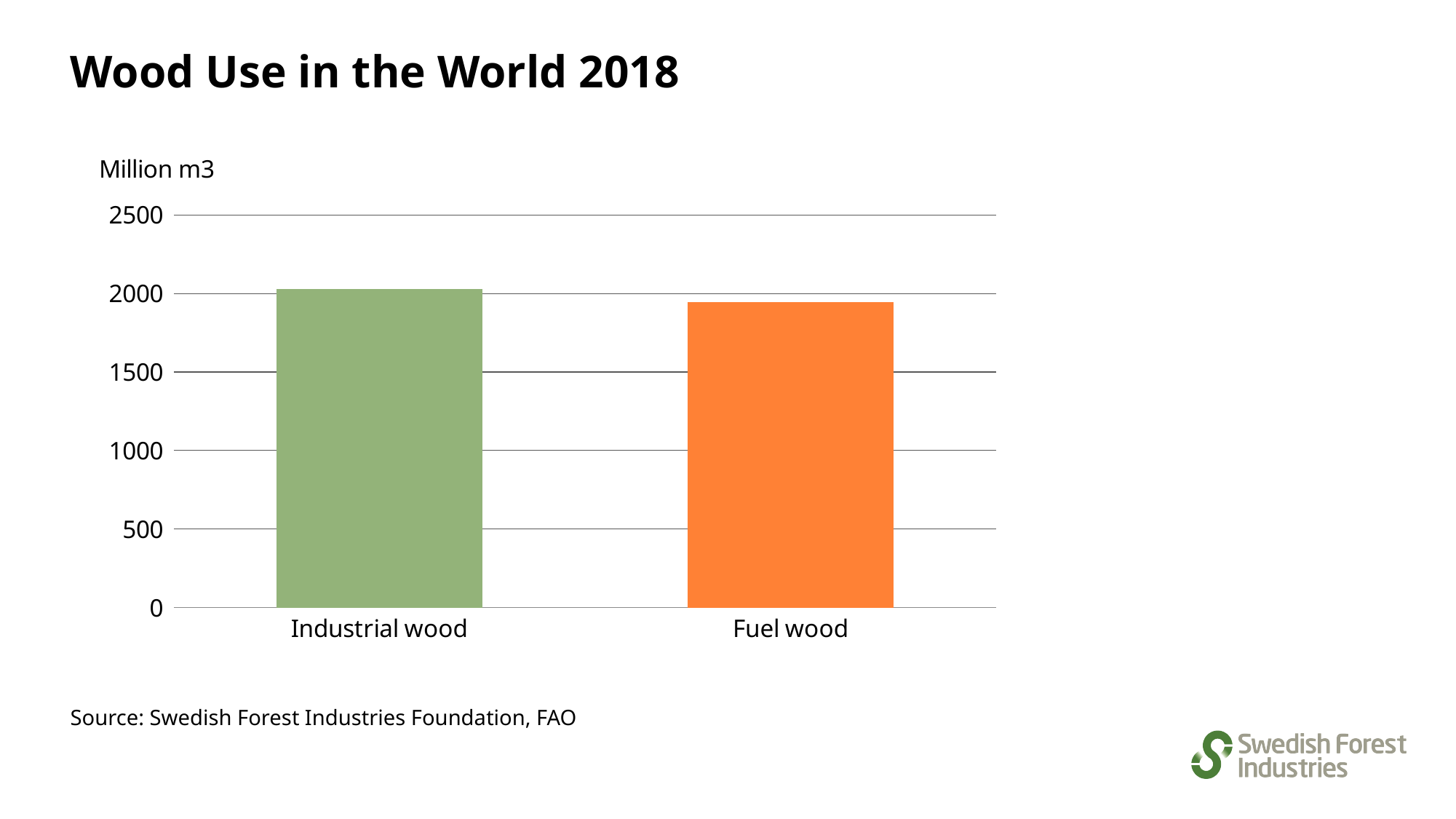
Which category has the lowest value? Fuel wood Is the value for Industrial wood greater or less than 2500? less Is the value for Industrial wood greater or less than 1500? greater Which is larger, the value for Industrial wood or the value for Fuel wood? Industrial wood What kind of chart is shown on the slide? bar chart How many categories are plotted in the chart? 2 Is the value for Fuel wood greater or less than 1500? greater What is the title of the chart? Wood Use in the World 2018 Which category has the highest value? Industrial wood What unit is shown on the y axis of the chart? Million m3